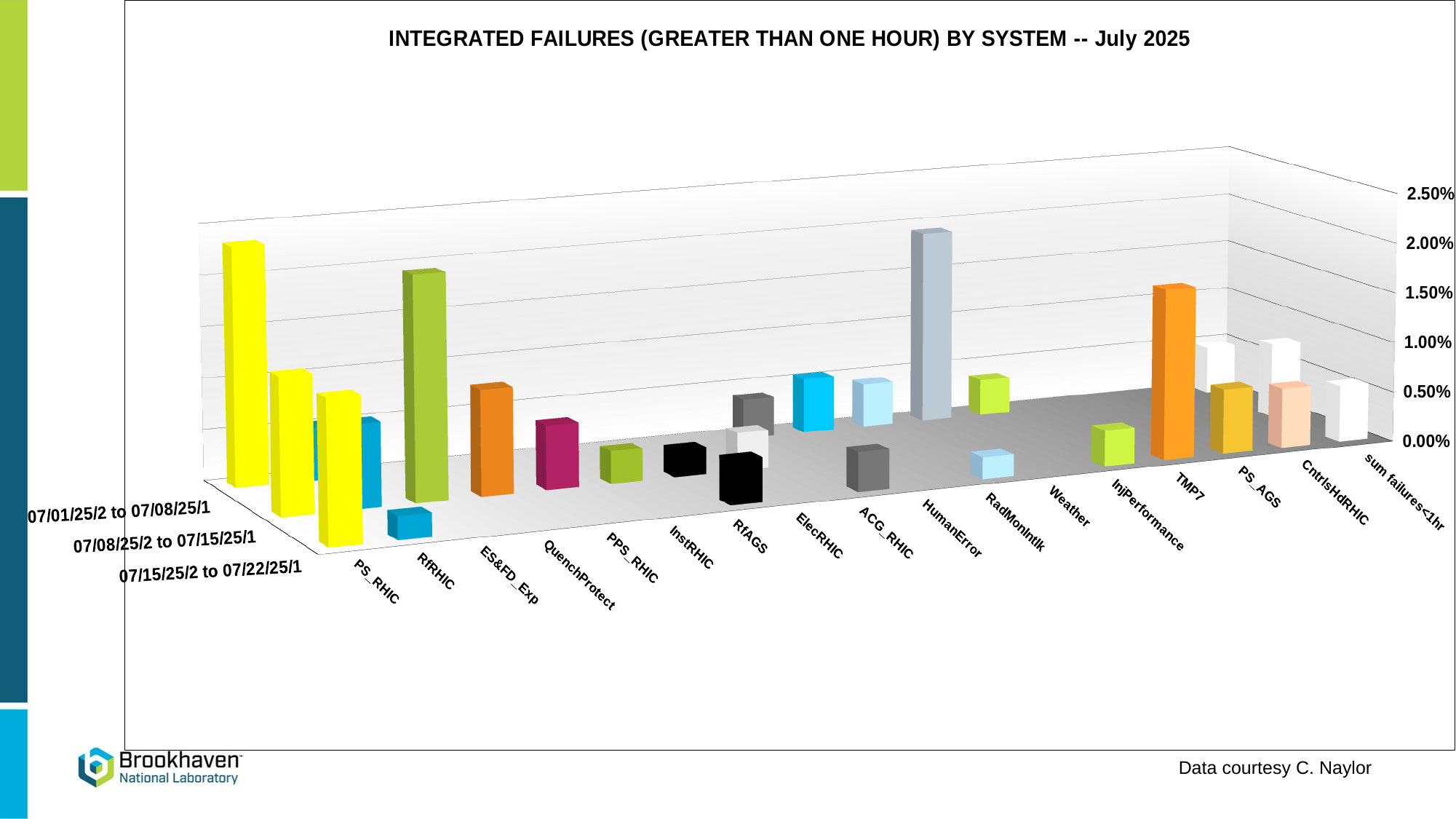
Is the value for PS_RHIC in the 07/01/25/2 to 07/08/25/1 period greater or less than 1.00%? greater How many time periods are plotted along the depth axis of the chart? 3 How many systems (categories) are shown along the x axis of the chart? 17 What kind of chart is shown on the slide? bar chart Which system has the tallest bar in the 07/15/25/2 to 07/22/25/1 period? TMP7 What is the title of the chart? INTEGRATED FAILURES (GREATER THAN ONE HOUR) BY SYSTEM -- July 2025 What is the highest tick value shown on the vertical axis? 2.50% Which is the last category label on the x axis of the chart? sum failures<1hr Is the value for HumanError in the 07/01/25/2 to 07/08/25/1 period greater or less than 1.00%? less